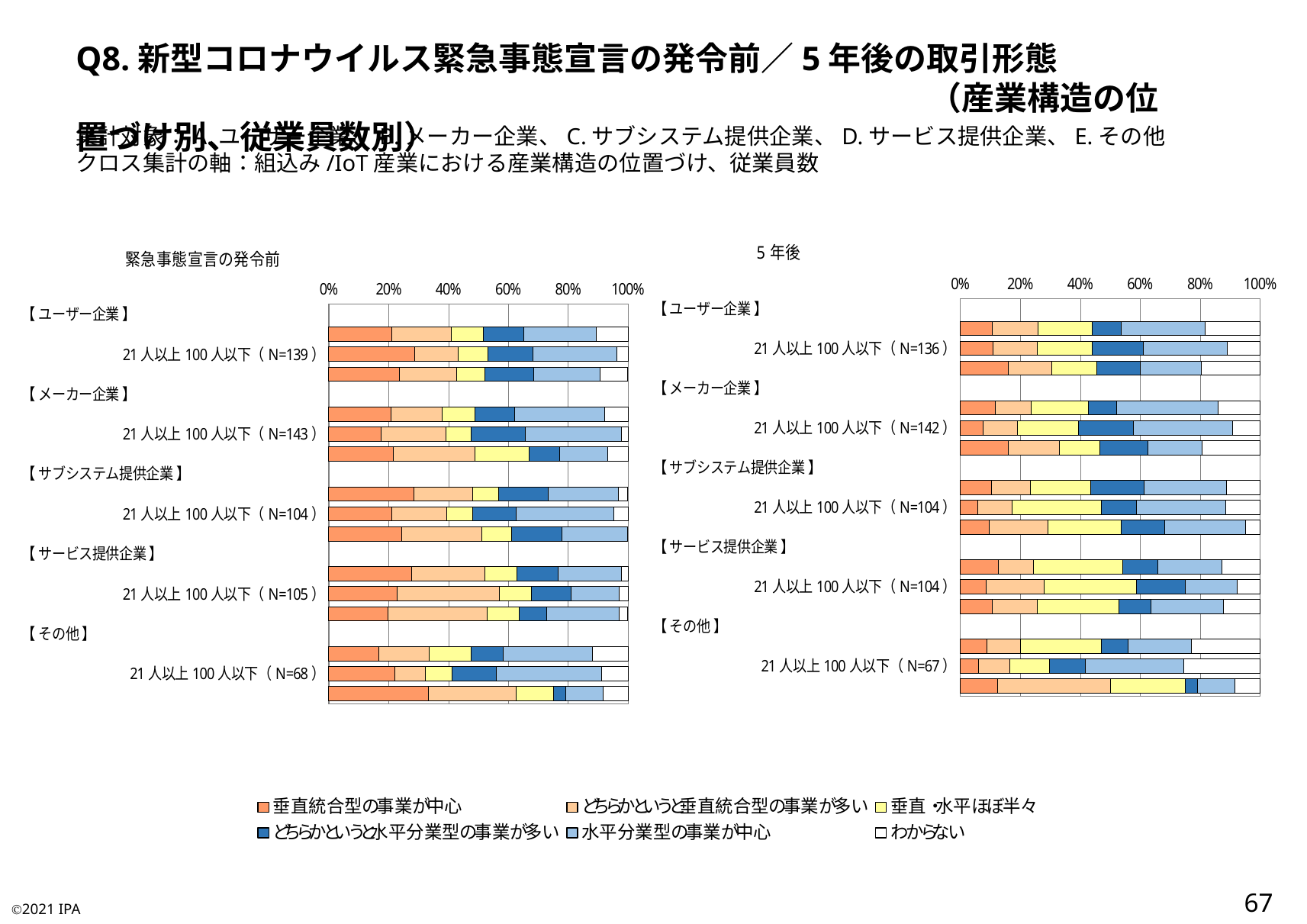
In the left chart 緊急事態宣言の発令前, is the 垂直統合型の事業が中心 share for the bottom bar under その他 greater or less than 20%? greater Which legend entry is shown with the white (unfilled) colour? わからない How many industry-position groups (bracketed headings) are shown in the left chart 緊急事態宣言の発令前? 5 In the right chart 5年後, is the どちらかというと垂直統合型の事業が多い share for the bottom bar under その他 greater or less than 20%? greater What is the title of the right chart? 5年後 What kind of chart is the left chart titled 緊急事態宣言の発令前? Stacked bar chart How many series does the legend list for the charts? 6 In the right chart 5年後, is the 垂直統合型の事業が中心 share for the first bar under メーカー企業 greater or less than 20%? less In the right chart 5年後, what is the N for the 21人以上100人以下 row under メーカー企業? N=142 How many bars are plotted in the right chart 5年後? 15 In the right chart 5年後, what is the N for the 21人以上100人以下 row under その他? N=67 In the left chart 緊急事態宣言の発令前, what is the N for the 21人以上100人以下 row under ユーザー企業? N=139